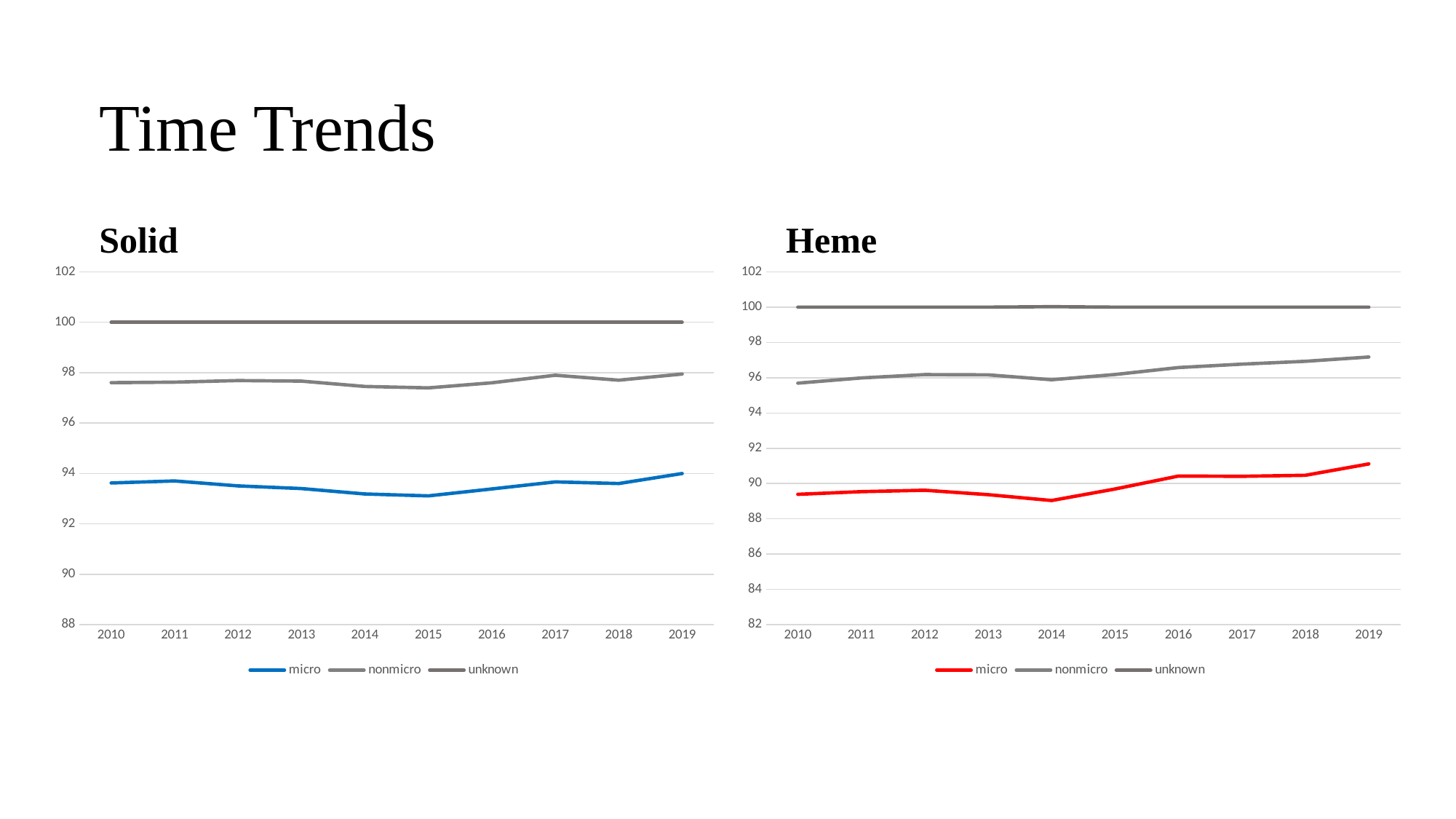
In the Solid chart, what is the value of the unknown series in 2010? 100 In the Heme chart, is the value for micro in 2014 greater or less than 90? less In the Heme chart, is the value for micro in 2019 greater or less than 90? greater In the Heme chart, does the nonmicro series rise or fall overall from 2010 to 2019? rise In the Heme chart, is the value for nonmicro in 2019 greater or less than 96? greater In the Heme chart, what colour is the micro series line? red How many series does the legend of the Heme chart list? 3 What kind of chart is the Solid chart? line chart How many years are plotted along the x axis of the Solid chart? 10 In the Heme chart, which is larger for the micro series: the value in 2010 or the value in 2019? 2019